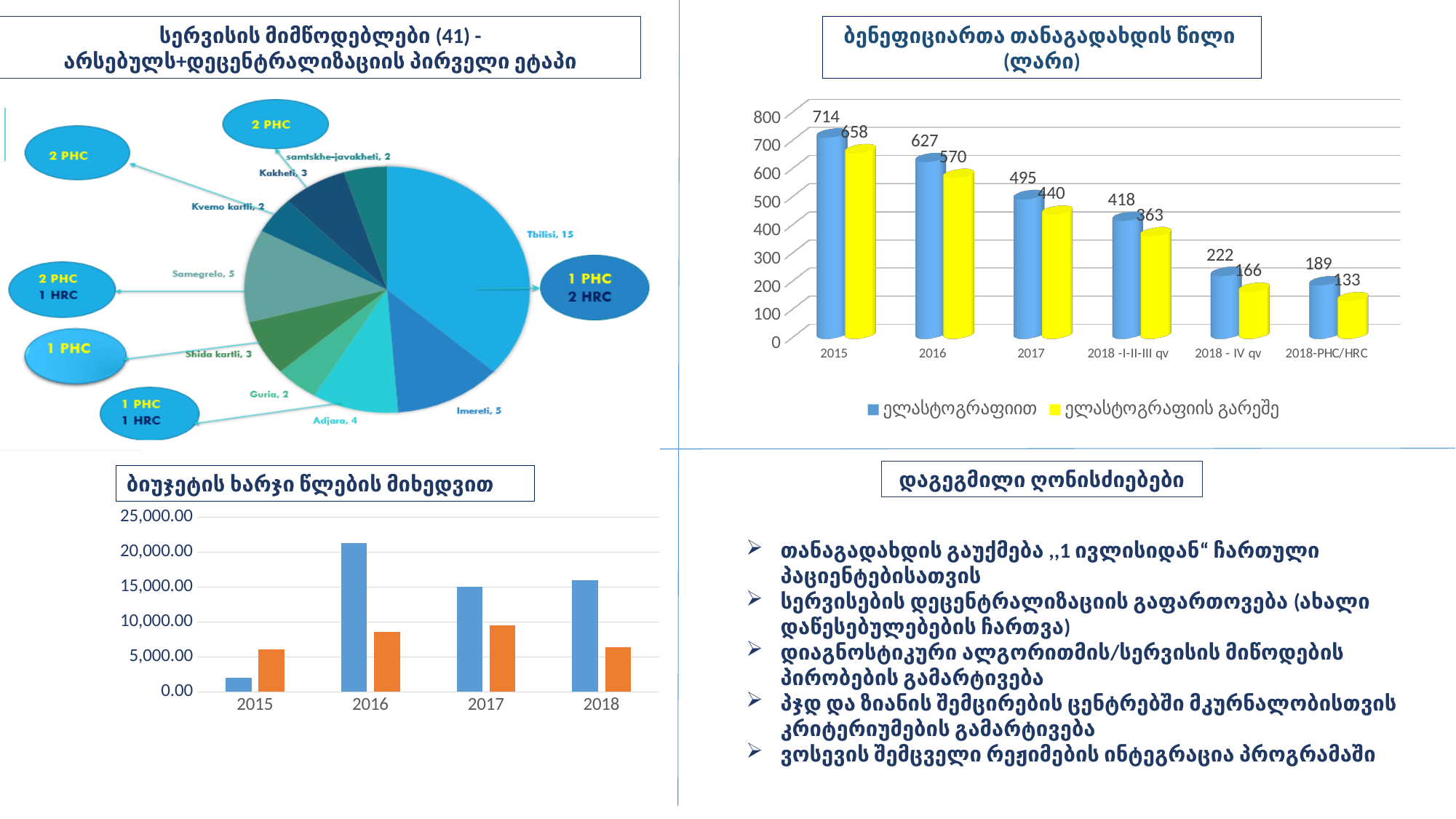
In the bottom-left chart (ბიუჯეტის ხარჯი წლების მიხედვით), is the value of the blue bar for 2016 greater or less than 20,000.00? greater In the top-left pie chart (სერვისის მიმწოდებლები), what is the value for Adjara? 4 In the top-right chart (ბენეფიციართა თანაგადახდის წილი), how many categories are shown on the x axis? 6 In the top-right chart (ბენეფიციართა თანაგადახდის წილი), what is the value of the blue series (ელასტოგრაფიით) for 2015? 714 In the top-right chart (ბენეფიციართა თანაგადახდის წილი), how many series does the legend list? 2 In the bottom-left chart (ბიუჯეტის ხარჯი წლების მიხედვით), which year has the highest blue bar? 2016 In the top-left pie chart (სერვისის მიმწოდებლები), how many slices does the pie have? 9 In the top-left pie chart (სერვისის მიმწოდებლები), which region has the largest slice? Tbilisi In the top-right chart (ბენეფიციართა თანაგადახდის წილი), which category has the lowest value for the yellow series (ელასტოგრაფიის გარეშე)? 2018-PHC/HRC In the top-right chart (ბენეფიციართა თანაგადახდის წილი), what is the value of the yellow series (ელასტოგრაფიის გარეშე) for 2018 - IV qv? 166 In the top-right chart (ბენეფიციართა თანაგადახდის წილი), do the values of the blue series rise or fall from 2015 to 2018-PHC/HRC? fall In the top-right chart (ბენეფიციართა თანაგადახდის წილი), what is the difference between the blue and yellow values for 2017? 55